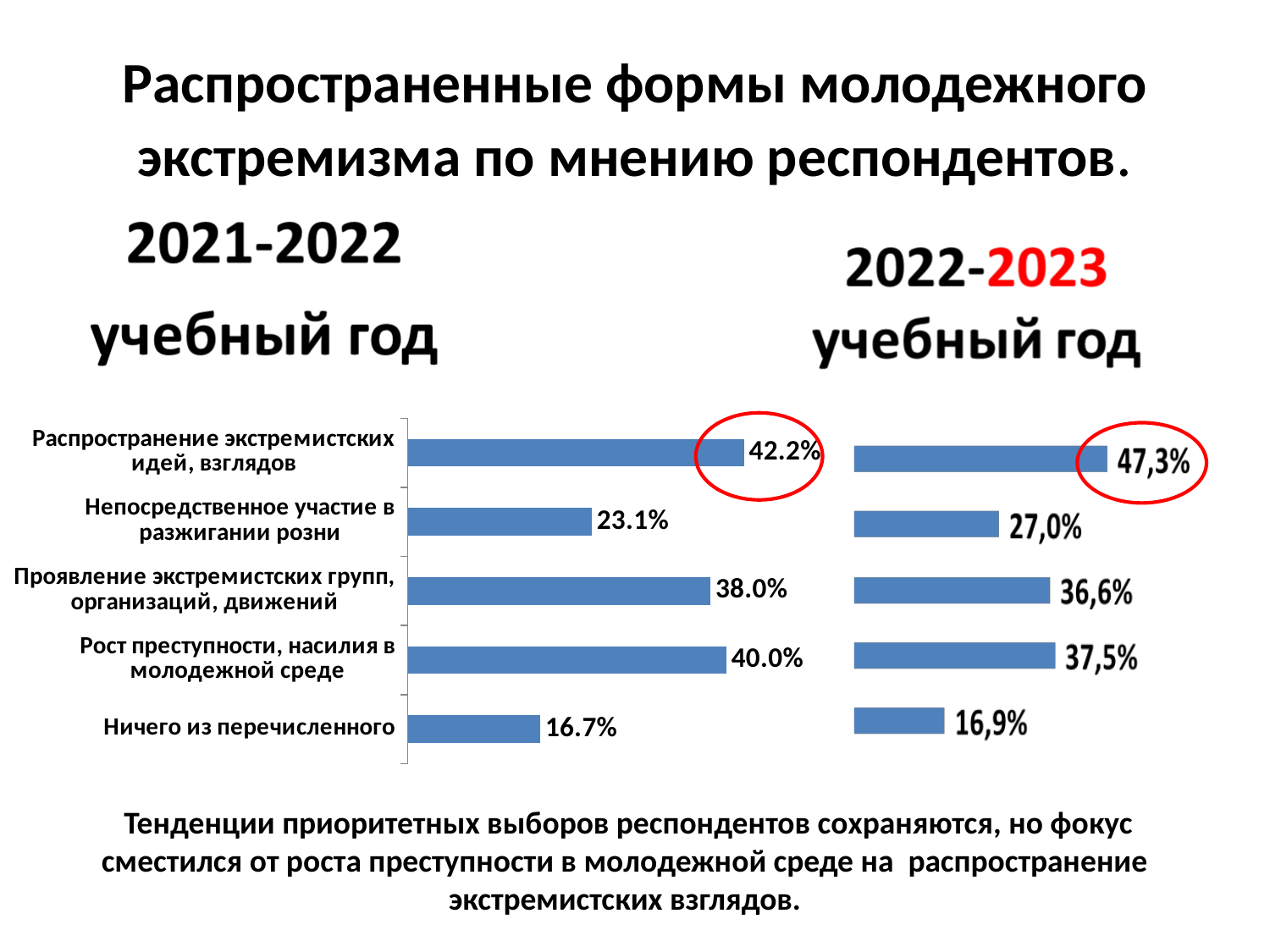
In the 2022-2023 учебный год chart, what is the value for «Непосредственное участие в разжигании розни»? 27,0% How many categories does the 2021-2022 учебный год chart show? 5 In the 2021-2022 учебный год chart, what is the difference between «Рост преступности, насилия в молодежной среде» and «Проявление экстремистских групп, организаций, движений»? 2.0% In the 2022-2023 учебный год chart, what is the value for «Рост преступности, насилия в молодежной среде»? 37,5% What kind of chart is the 2022-2023 учебный год chart? Bar chart In the 2022-2023 учебный год chart, which is larger: «Проявление экстремистских групп, организаций, движений» or «Рост преступности, насилия в молодежной среде»? Рост преступности, насилия в молодежной среде In the 2021-2022 учебный год chart, what is the value for «Распространение экстремистских идей, взглядов»? 42.2% In the 2022-2023 учебный год chart, which category has the lowest value? Ничего из перечисленного In the 2021-2022 учебный год chart, which is larger: «Непосредственное участие в разжигании розни» or «Ничего из перечисленного»? Непосредственное участие в разжигании розни In the 2022-2023 учебный год chart, which data label is circled in red? 47,3% In the 2021-2022 учебный год chart, which category has the highest value? Распространение экстремистских идей, взглядов In the 2022-2023 учебный год chart, what is the difference between «Распространение экстремистских идей, взглядов» and «Ничего из перечисленного»? 30,4%